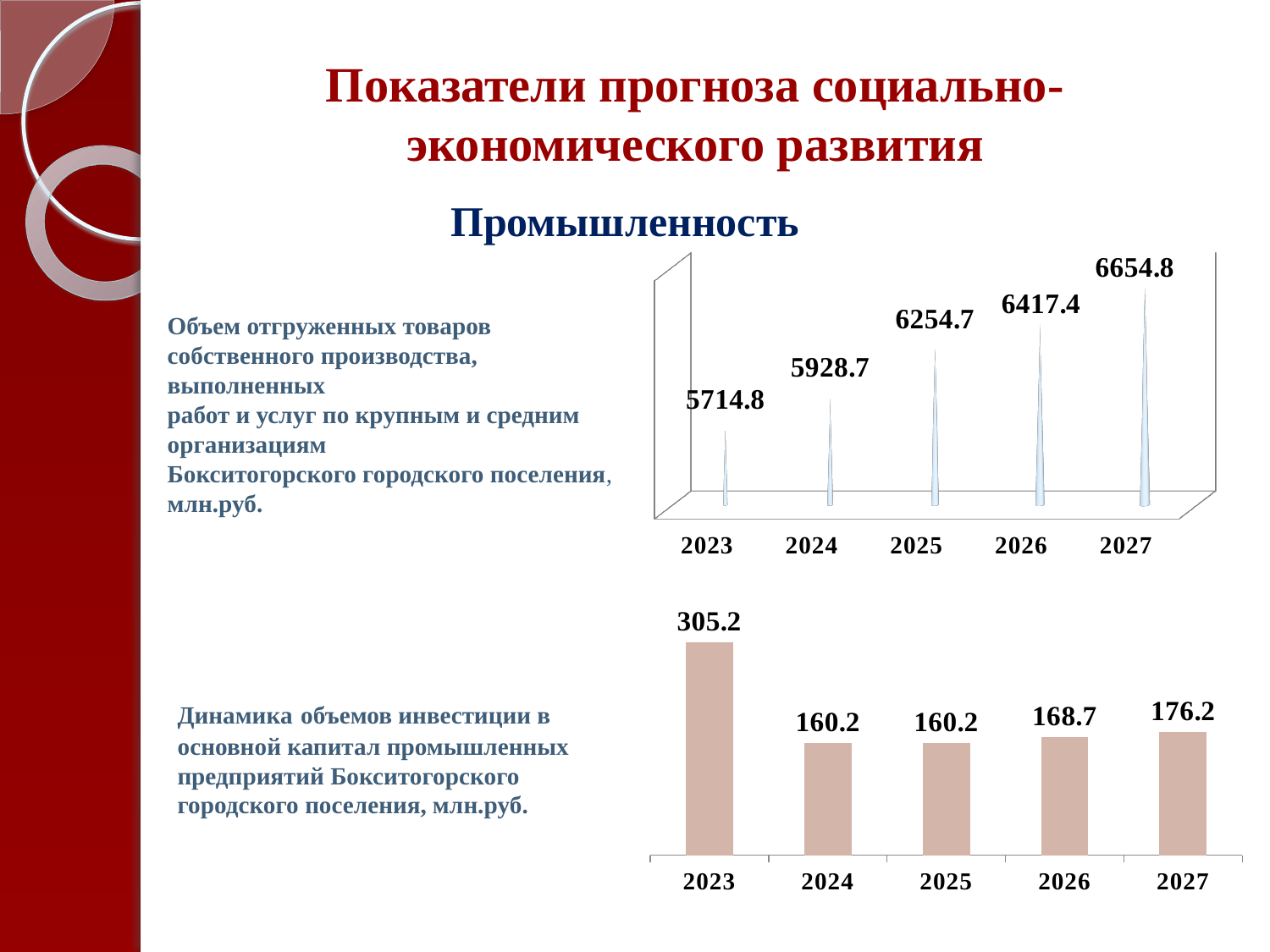
In the top chart (volume of shipped goods), what is the value for 2023? 5714.8 In the top chart (volume of shipped goods), what is the value for 2025? 6254.7 In the bottom chart (investment in fixed capital), which year has the highest value? 2023 In the bottom chart (investment in fixed capital), which is larger, the value for 2027 or the value for 2025? 2027 In the bottom chart (investment in fixed capital), what is the difference between the values for 2023 and 2024? 145.0 How many years are shown on the x axis of the bottom chart (investment in fixed capital)? 5 In the bottom chart (investment in fixed capital), what is the value for 2023? 305.2 In the top chart (volume of shipped goods), which year has the lowest value? 2023 In the top chart (volume of shipped goods), which year has the highest value? 2027 In the bottom chart (investment in fixed capital), what is the value for 2026? 168.7 In the top chart (volume of shipped goods), what is the difference between the values for 2027 and 2026? 237.4 In the top chart (volume of shipped goods), do the values rise or fall from 2023 to 2027? rise